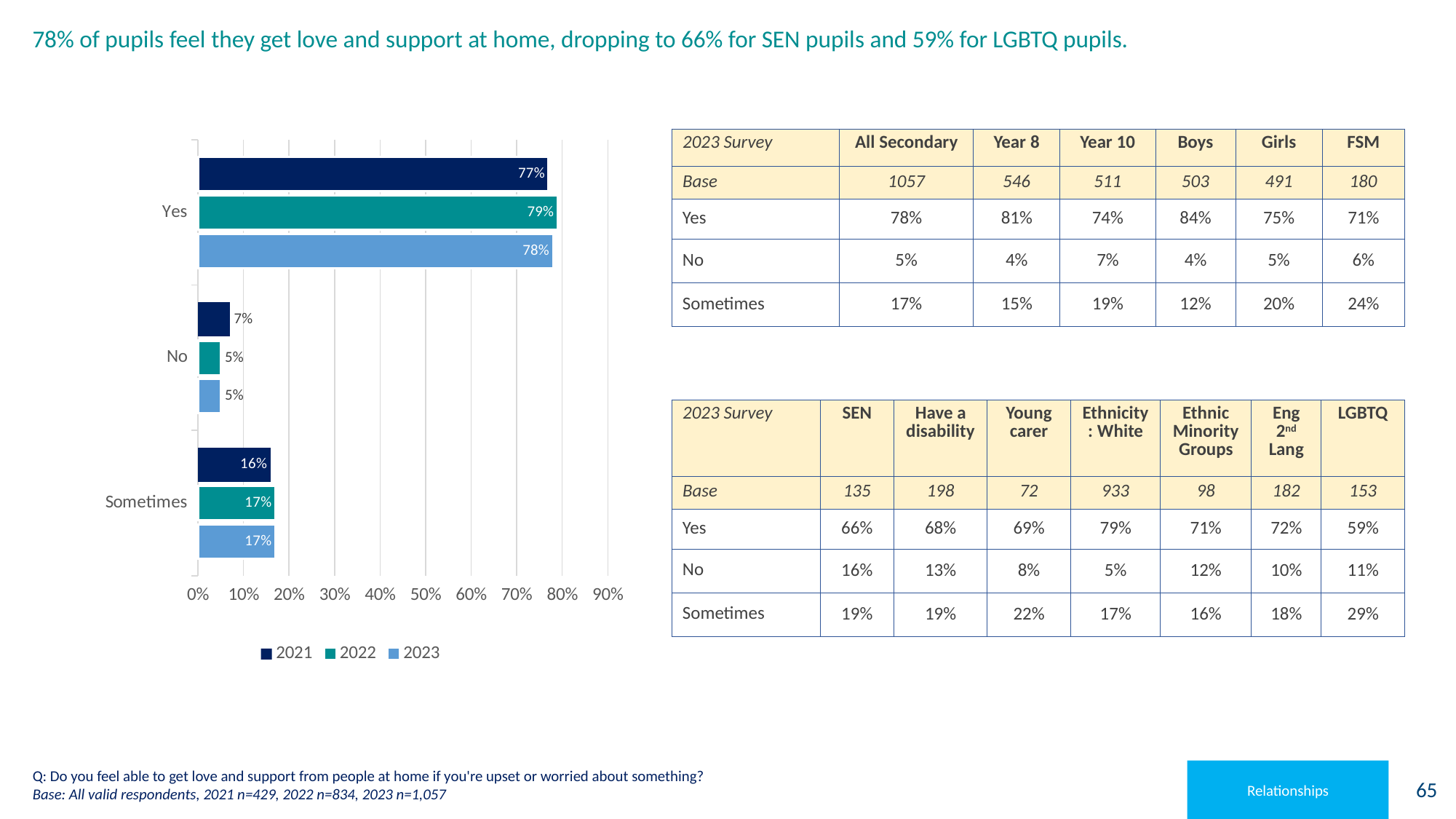
What kind of chart is shown on the slide? bar chart Which response category has the lowest values across all years? No How many series does the legend list? 3 What is the value for 'No' in 2021? 7% Is the 2021 value for 'Sometimes' larger or smaller than the 2023 value for 'Sometimes'? smaller Which series is shown in the darkest blue colour? 2021 What is the difference between the 'Yes' values for 2022 and 2021? 2% What is the value for 'Sometimes' in 2022? 17% Which year has the highest value for 'Yes'? 2022 How many response categories are shown on the y axis? 3 Is the value for 'Yes' in 2021 greater or less than 70%? greater What is the value for 'Yes' in 2023? 78%